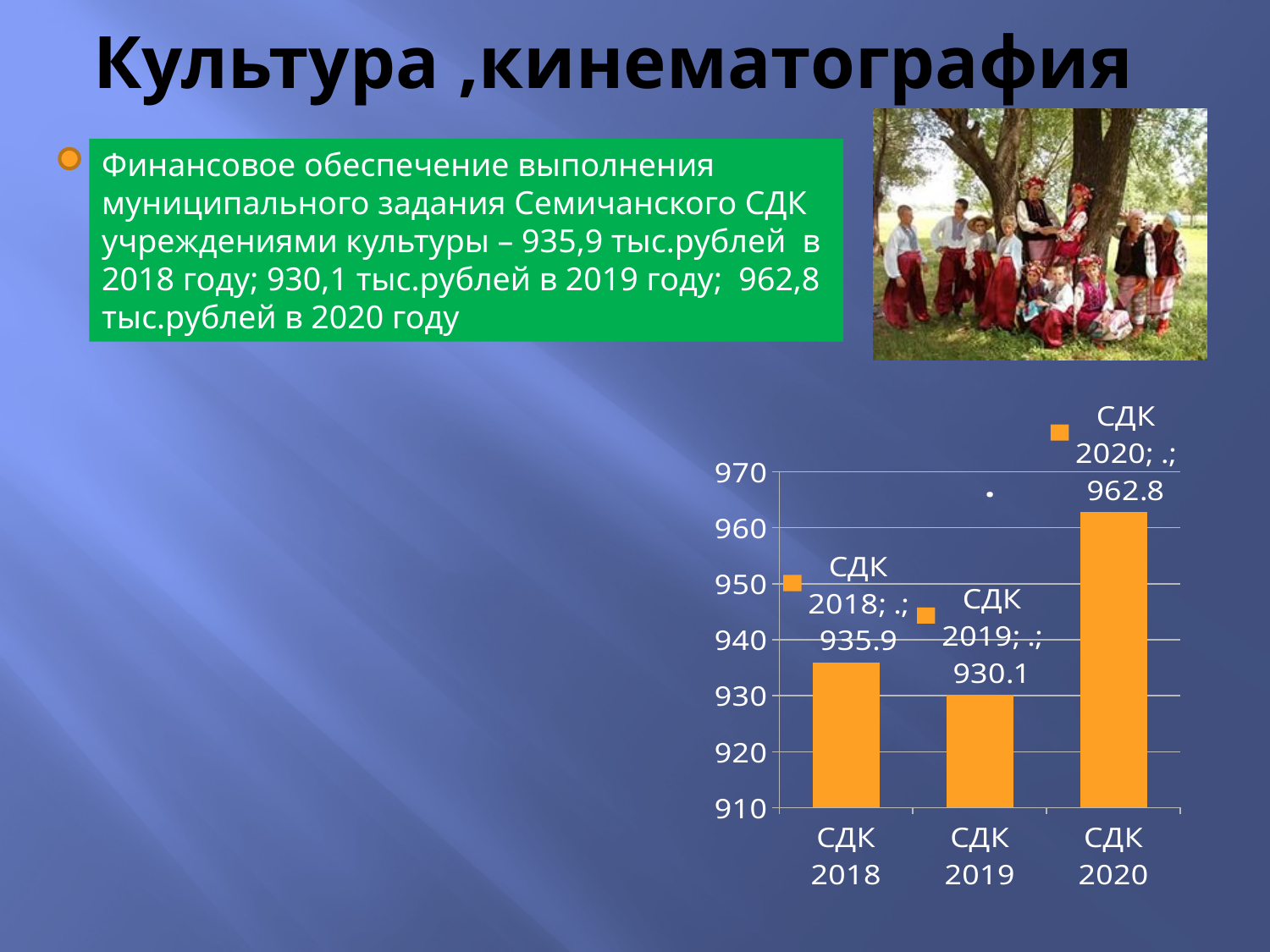
How many categories are shown in the bar chart? 3 What kind of chart is shown on the slide? bar chart What is the difference between the values for СДК 2020 and СДК 2019? 32.7 What is the value for СДК 2020 in the bar chart? 962.8 Which is larger, the value for СДК 2018 or the value for СДК 2020? СДК 2020 Which category has the highest value in the bar chart? СДК 2020 What is the value for СДК 2018 in the bar chart? 935.9 Is the value for СДК 2019 greater or less than 940? less What is the difference between the values for СДК 2018 and СДК 2019? 5.8 What is the value for СДК 2019 in the bar chart? 930.1 Is the value for СДК 2020 greater or less than 960? greater Which category has the lowest value in the bar chart? СДК 2019